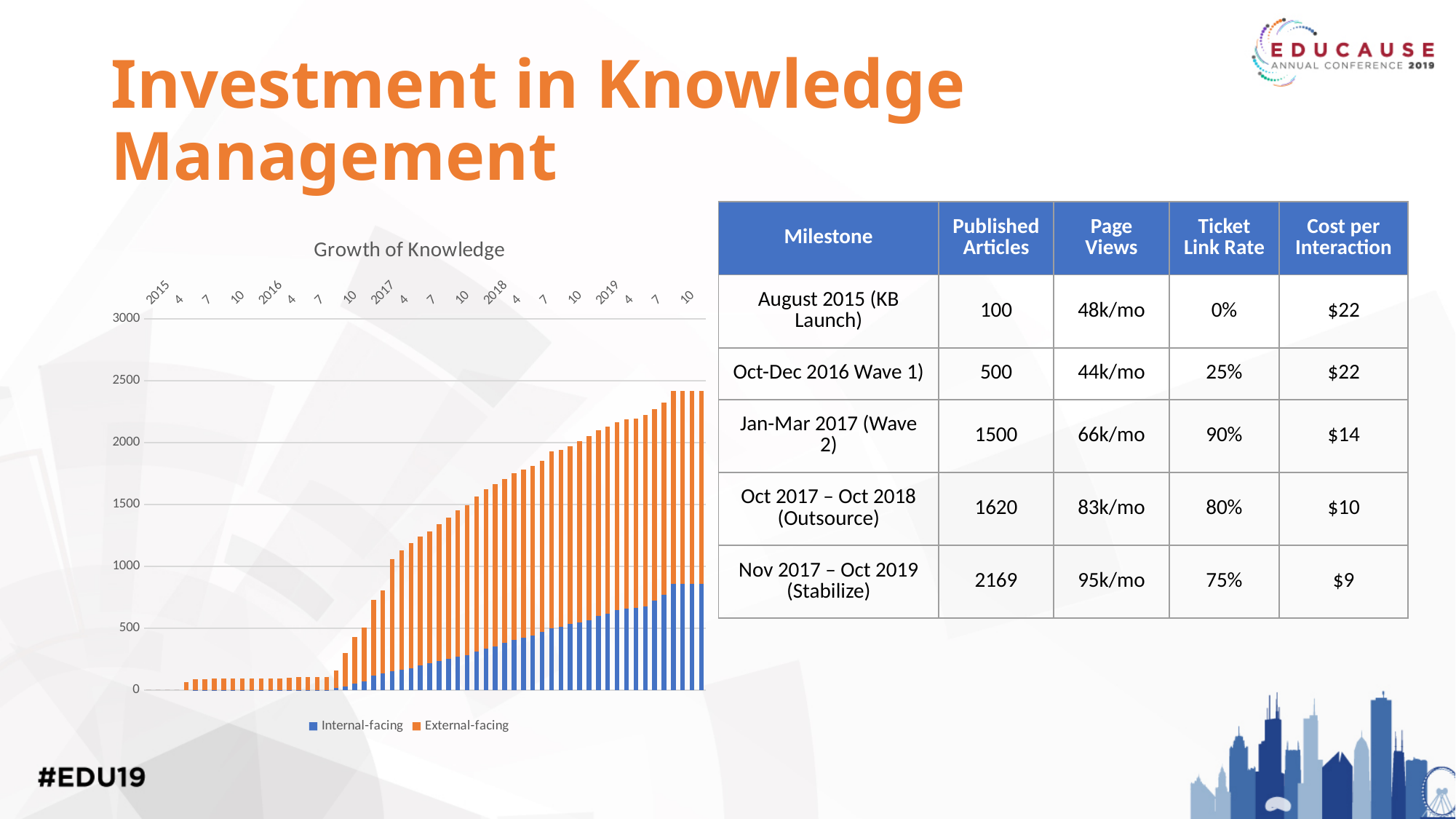
In the "Growth of Knowledge" chart, is the total of the last bar (2019, month 10) greater or less than 2000? greater What kind of chart is the "Growth of Knowledge" chart? Stacked bar chart In the "Growth of Knowledge" chart, is the Internal-facing value in the last bar (2019, month 10) greater or less than 1000? less In the last bar of the "Growth of Knowledge" chart (2019, month 10), which series is larger, Internal-facing or External-facing? External-facing In the "Growth of Knowledge" chart, is the Internal-facing value in the last bar (2019, month 10) greater or less than 500? greater What is the highest value shown on the y axis of the "Growth of Knowledge" chart? 3000 What are the two series named in the legend of the "Growth of Knowledge" chart? Internal-facing and External-facing Do the stacked totals in the "Growth of Knowledge" chart rise or fall along the x axis from 2015 to 2019? Rise In the "Growth of Knowledge" chart, which colour represents the External-facing series? Orange How many series does the legend of the "Growth of Knowledge" chart list? 2